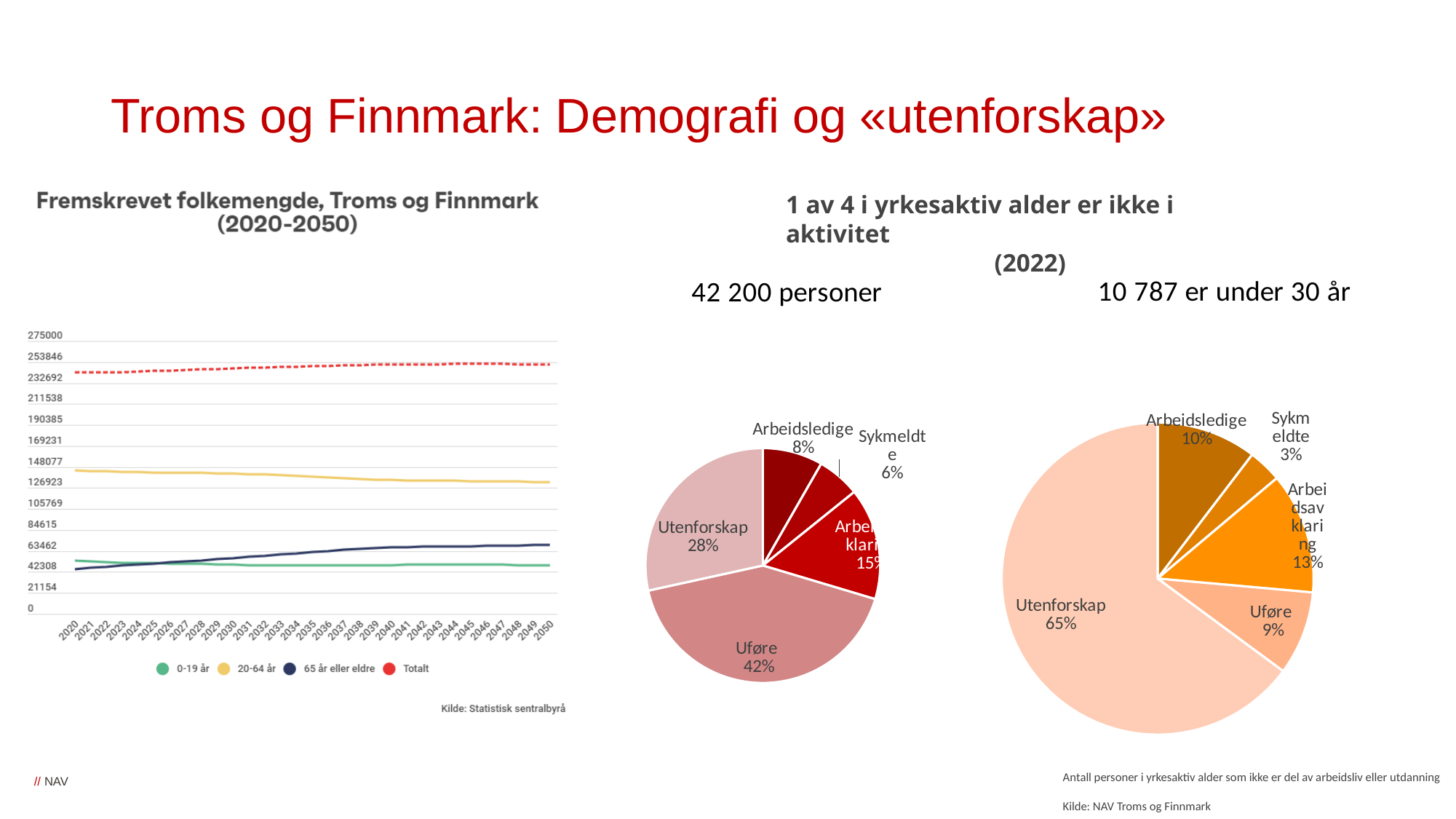
How many slices does the pie chart labelled "42 200 personer" have? 5 In the pie chart labelled "10 787 er under 30 år", what share is Utenforskap? 65% In the chart "Fremskrevet folkemengde, Troms og Finnmark (2020-2050)", is the Totalt value in 2050 greater or less than 211538? greater In the chart "Fremskrevet folkemengde, Troms og Finnmark (2020-2050)", does the 20-64 år series rise or fall from 2020 to 2050? Fall In the pie chart labelled "42 200 personer", what is the difference in percentage points between Uføre and Utenforskap? 14 How many series does the legend of the chart "Fremskrevet folkemengde, Troms og Finnmark (2020-2050)" list? 4 In the pie chart labelled "42 200 personer", what share is Uføre? 42% In the pie chart labelled "42 200 personer", which category has the largest share? Uføre In the pie chart labelled "10 787 er under 30 år", which category has the smallest share? Sykmeldte In the pie chart labelled "10 787 er under 30 år", which is larger: Arbeidsledige or Uføre? Arbeidsledige What kind of chart is "Fremskrevet folkemengde, Troms og Finnmark (2020-2050)"? Line chart In the pie chart labelled "10 787 er under 30 år", what share is Arbeidsavklaring? 13%